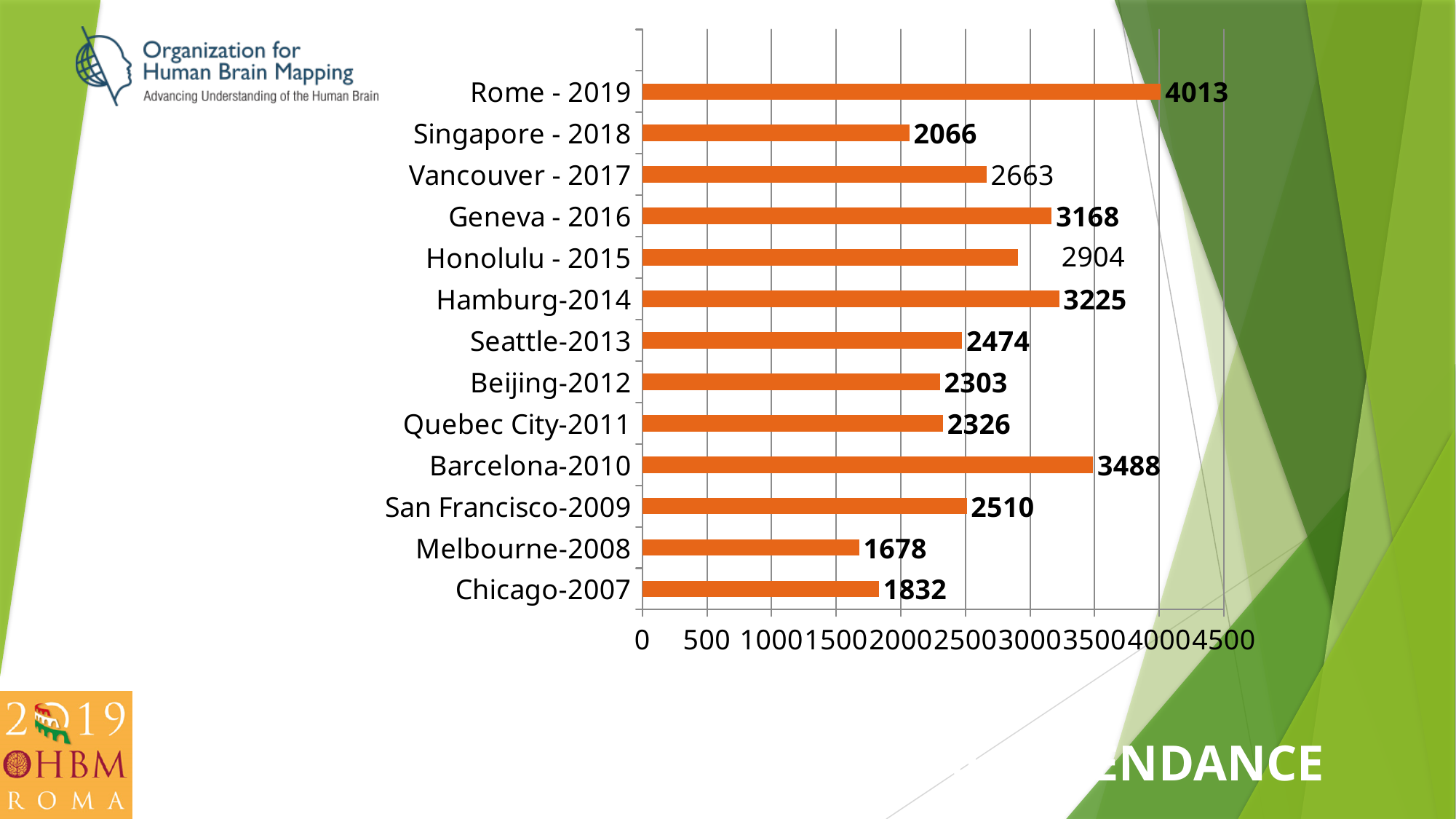
What is the value for Melbourne-2008? 1678 Which is larger, the value for Geneva - 2016 or the value for Hamburg-2014? Hamburg-2014 Which category has the highest value? Rome - 2019 How many categories are shown in the chart? 13 What is the difference between the values for Barcelona-2010 and Chicago-2007? 1656 What is the difference between the values for Rome - 2019 and Singapore - 2018? 1947 What is the value for Honolulu - 2015? 2904 Is the value for Barcelona-2010 greater or less than 3000? greater Which category has the lowest value? Melbourne-2008 What kind of chart is shown on the slide? Bar chart Which is larger, the value for Vancouver - 2017 or the value for Seattle-2013? Vancouver - 2017 What is the value for Rome - 2019? 4013